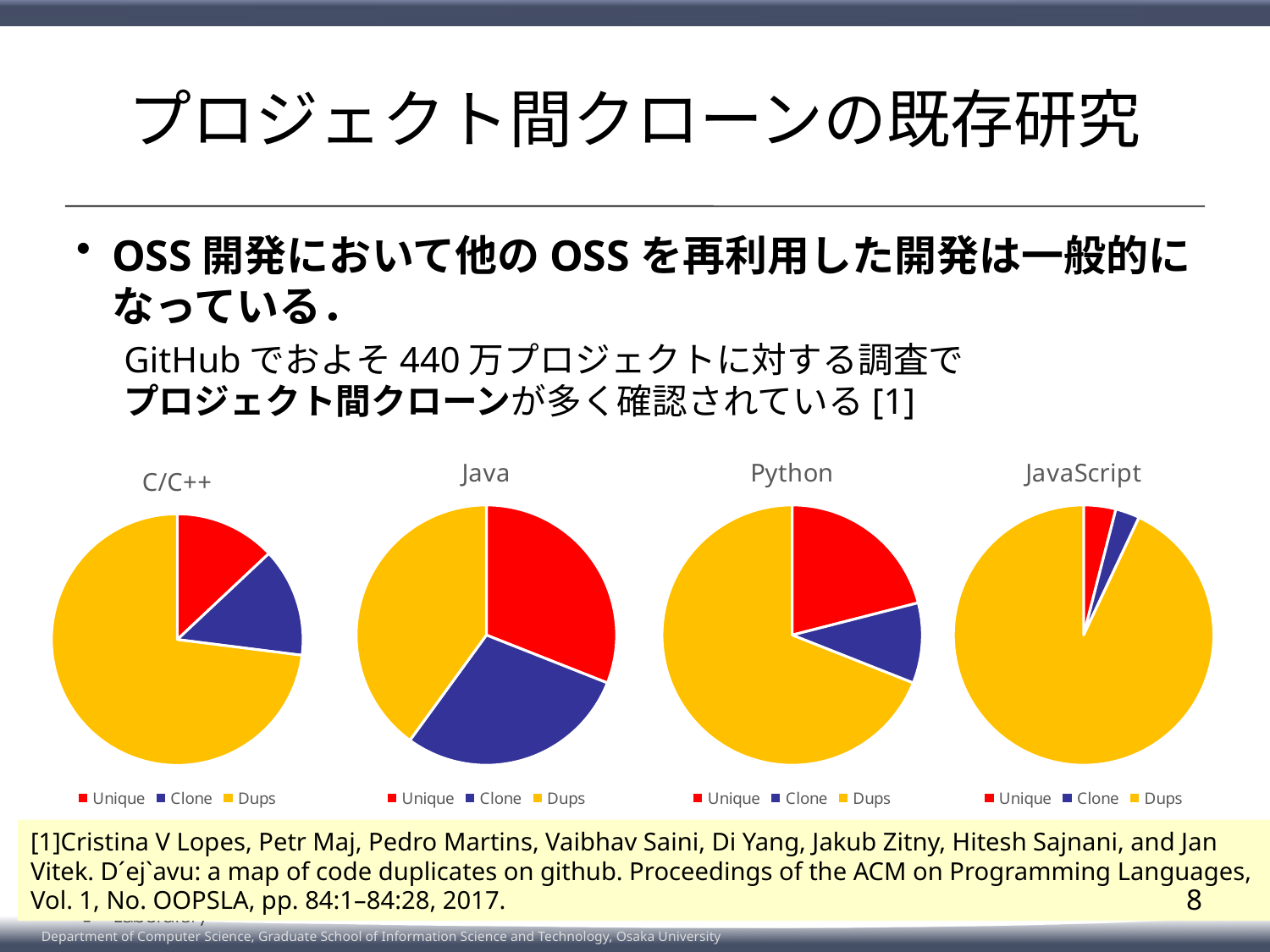
In the JavaScript pie chart, which category has the largest slice? Dups In the Python pie chart, which category has the largest slice? Dups In the C/C++ pie chart, which category has the largest slice? Dups In the JavaScript pie chart, which slice is larger, Dups or Unique? Dups In the Python pie chart, which slice is larger, Unique or Clone? Unique What are the titles of the four pie charts on the slide, from left to right? C/C++, Java, Python, JavaScript In the C/C++ pie chart, which slice is larger, Dups or Clone? Dups In the Python pie chart, which category has the smallest slice? Clone In the pie charts, which colour represents the Clone category? blue What kind of chart is used for the C/C++ data on the slide? pie chart How many pie charts are shown on the slide? 4 How many entries does the legend of the Java pie chart list? 3